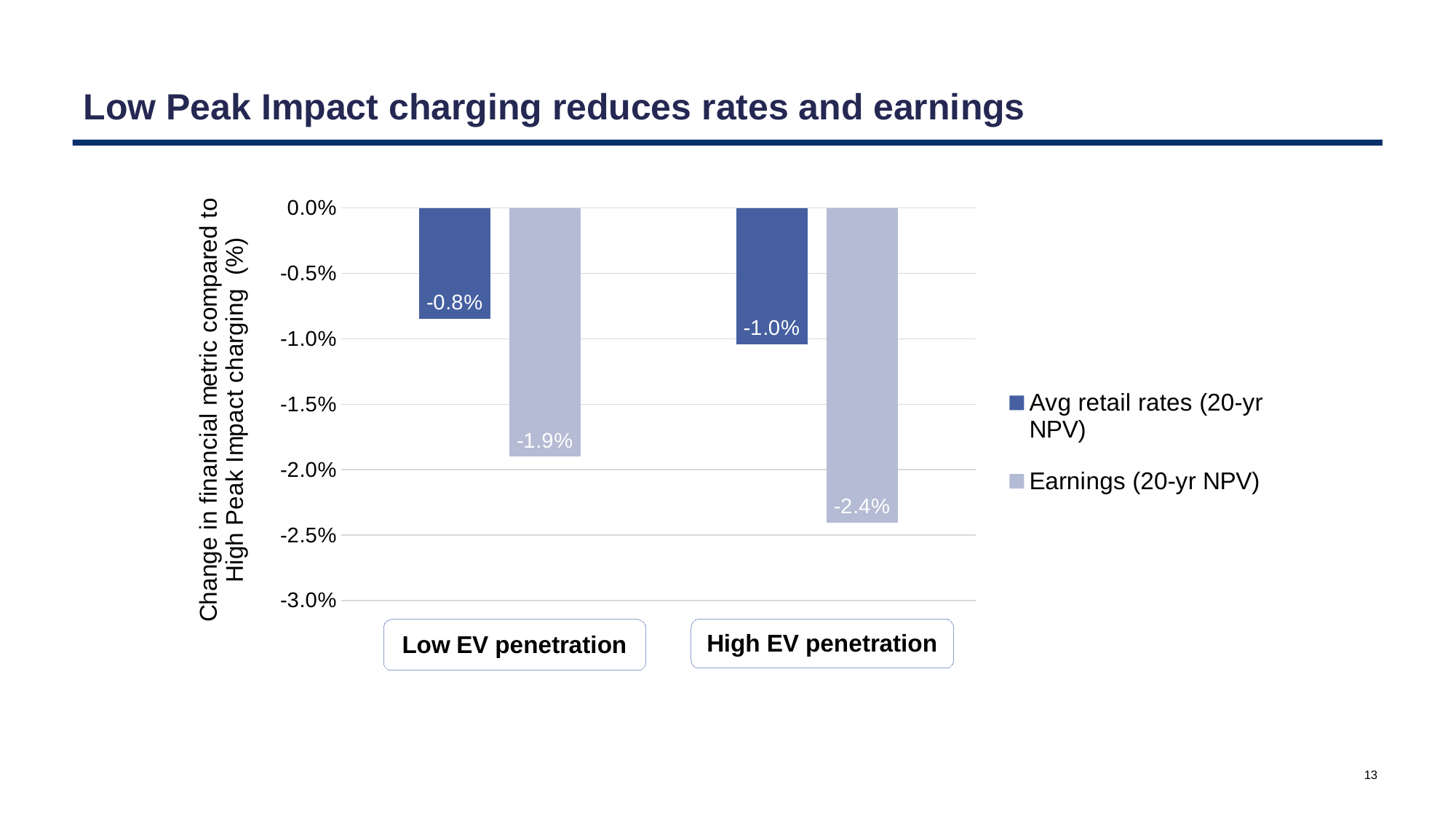
Which has a larger decrease under Low EV penetration: Avg retail rates (20-yr NPV) or Earnings (20-yr NPV)? Earnings (20-yr NPV) What is the difference between the Earnings (20-yr NPV) values for High EV penetration and Low EV penetration? 0.5% What is the value for Avg retail rates (20-yr NPV) under Low EV penetration? -0.8% What is the value for Earnings (20-yr NPV) under High EV penetration? -2.4% What is the value for Avg retail rates (20-yr NPV) under High EV penetration? -1.0% Which bar shows the largest decrease? Earnings (20-yr NPV), High EV penetration What kind of chart is shown on the slide? Bar chart Which bar shows the smallest decrease? Avg retail rates (20-yr NPV), Low EV penetration What is the value for Earnings (20-yr NPV) under Low EV penetration? -1.9% What is the y-axis label of the chart? Change in financial metric compared to High Peak Impact charging (%) How many categories are shown on the x axis? 2 How many series does the legend list? 2